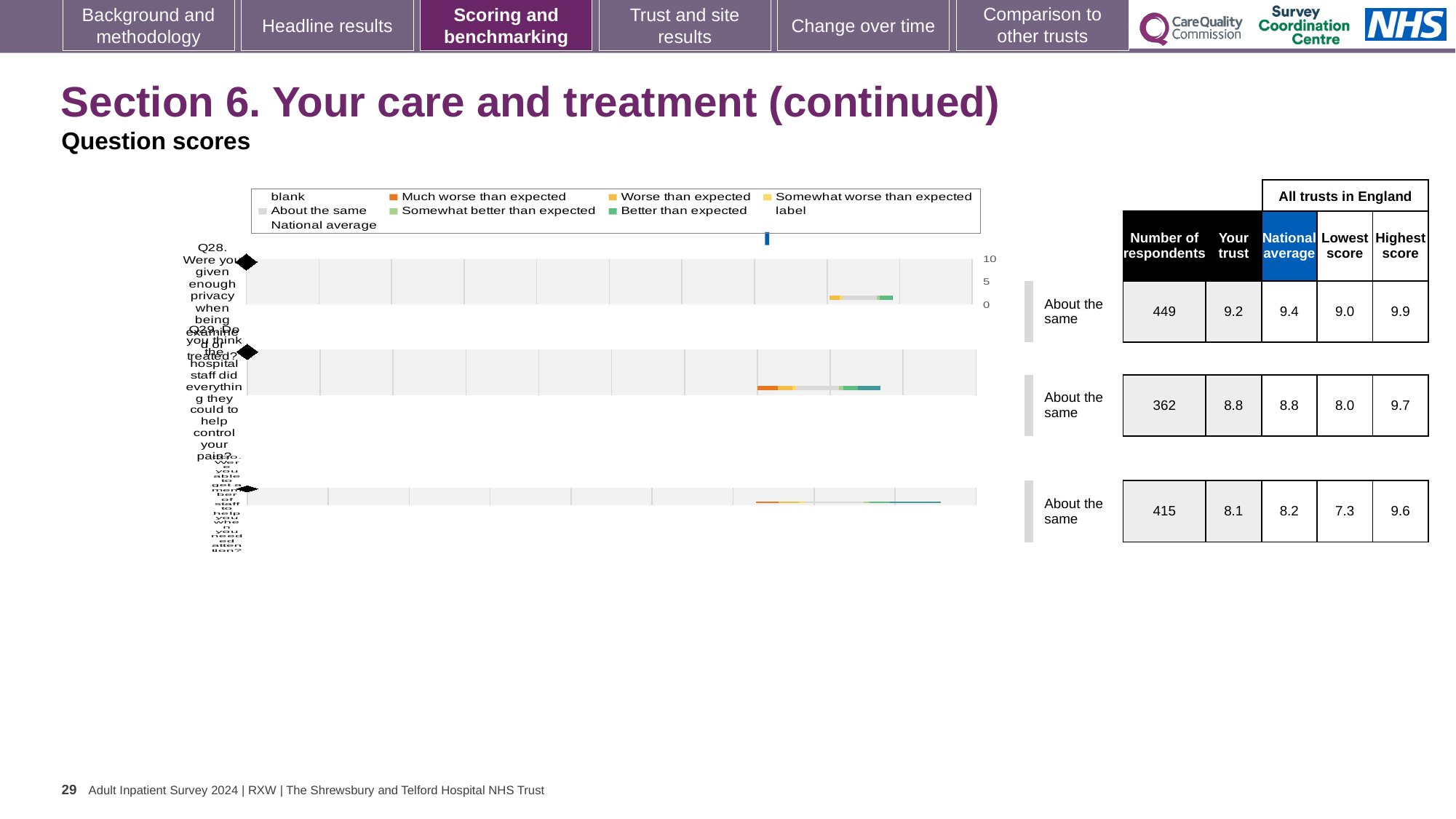
For Q29 (Do you think the hospital staff did everything they could to help control your pain?), what is the highest score among all trusts in England? 9.7 For Q29 (Do you think the hospital staff did everything they could to help control your pain?), what is the lowest score among all trusts in England? 8.0 What kind of chart is used to show the question scores on this slide? bar chart How many questions (charts) are shown on this slide? 3 For Q28 (Were you given enough privacy when being examined or treated?), what is the 'Your trust' score? 9.2 What is the maximum value shown on the score axis of the charts? 10 For the third chart (Q30), what is the 'Your trust' score? 8.1 Which question has the highest 'Your trust' score on this slide? Q28 For the third chart (Q30), what is the number of respondents? 415 For Q28 (Were you given enough privacy when being examined or treated?), what is the national average score? 9.4 For Q28 (Were you given enough privacy when being examined or treated?), how many respondents are there? 449 For Q28, what is the difference between the national average and the 'Your trust' score? 0.2